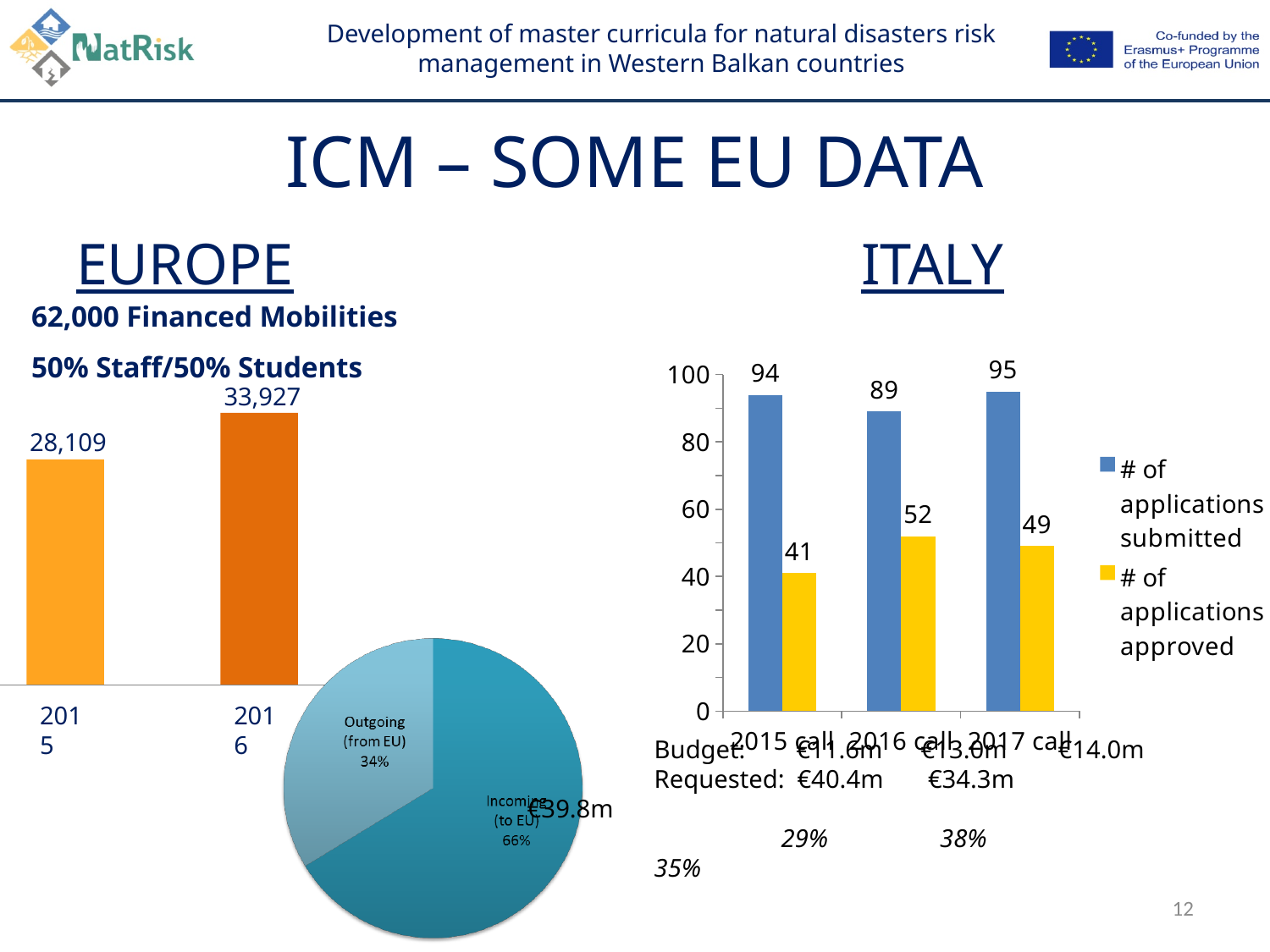
In the Italy chart, how many applications were submitted in the 2016 call? 89 In the pie chart, what share is labelled Incoming (to EU)? 66% In the Italy chart, how many applications were approved in the 2017 call? 49 In the Europe bar chart, what is the difference between the 2016 and 2015 values? 5,818 In the pie chart, what share is labelled Outgoing (from EU)? 34% In the Europe bar chart, what is the value for 2015? 28,109 In the Italy chart, what is the difference between applications submitted and approved in the 2015 call? 53 In the Italy chart, which call had the highest number of applications submitted? 2017 call In the Europe bar chart, what is the value for 2016? 33,927 In the Italy chart, which call had the lowest number of applications approved? 2015 call In the Italy chart, how many series does the legend list? 2 In the Europe bar chart, which year has the higher value, 2015 or 2016? 2016